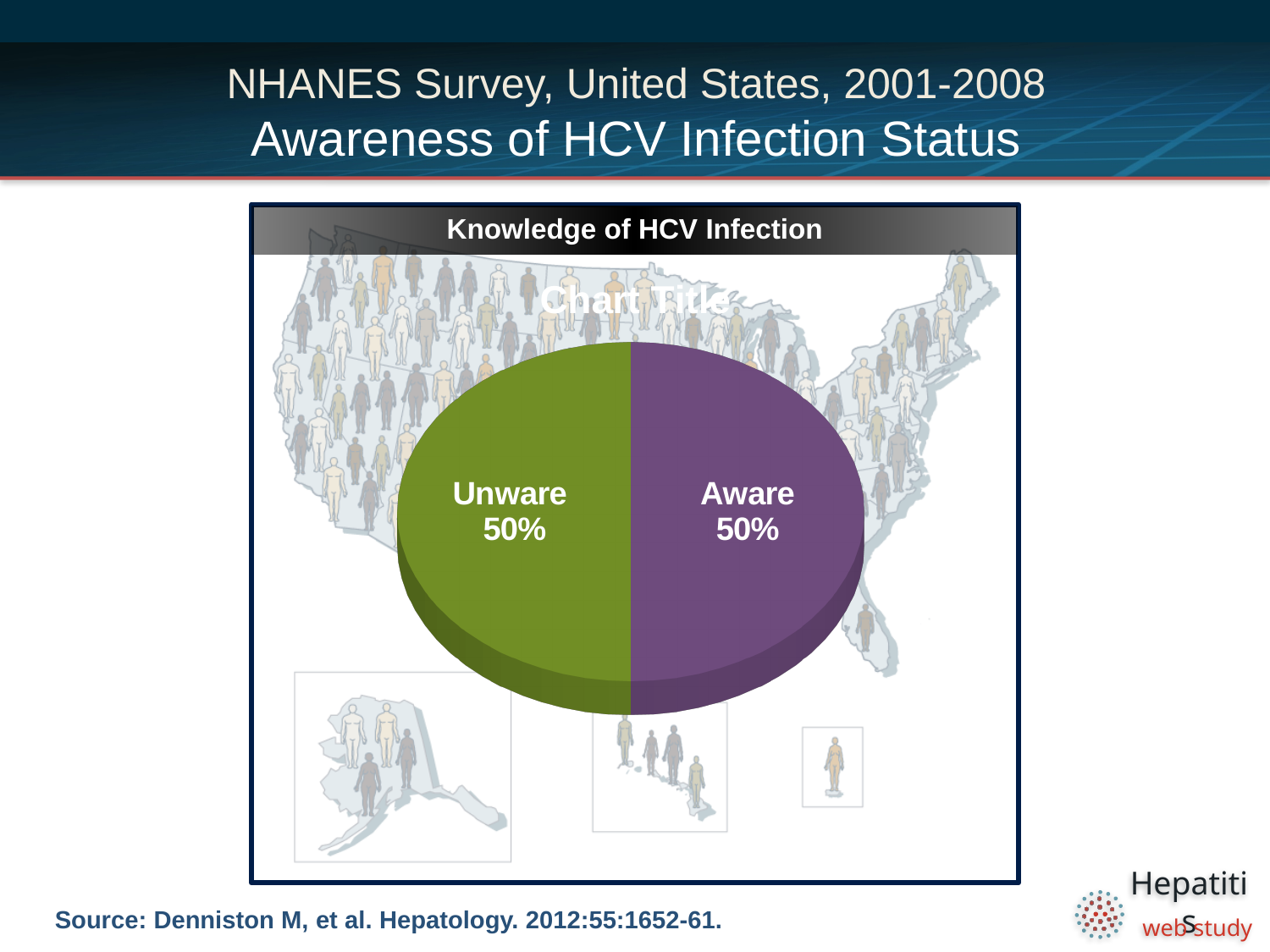
What share of the pie does the Aware slice represent? 50% What kind of chart is shown on the slide? Pie chart What percentage of the pie chart is labelled Unware? 50% What is the difference between the Aware and Unware percentages in the pie chart? 0% How many slices does the pie chart have? 2 What share of the pie does the Unware slice represent? 50% What heading appears in the bar above the pie chart? Knowledge of HCV Infection What colour is the Aware slice of the pie chart? Purple What is the combined percentage of the Aware and Unware slices? 100% What percentage of the pie chart is labelled Aware? 50%